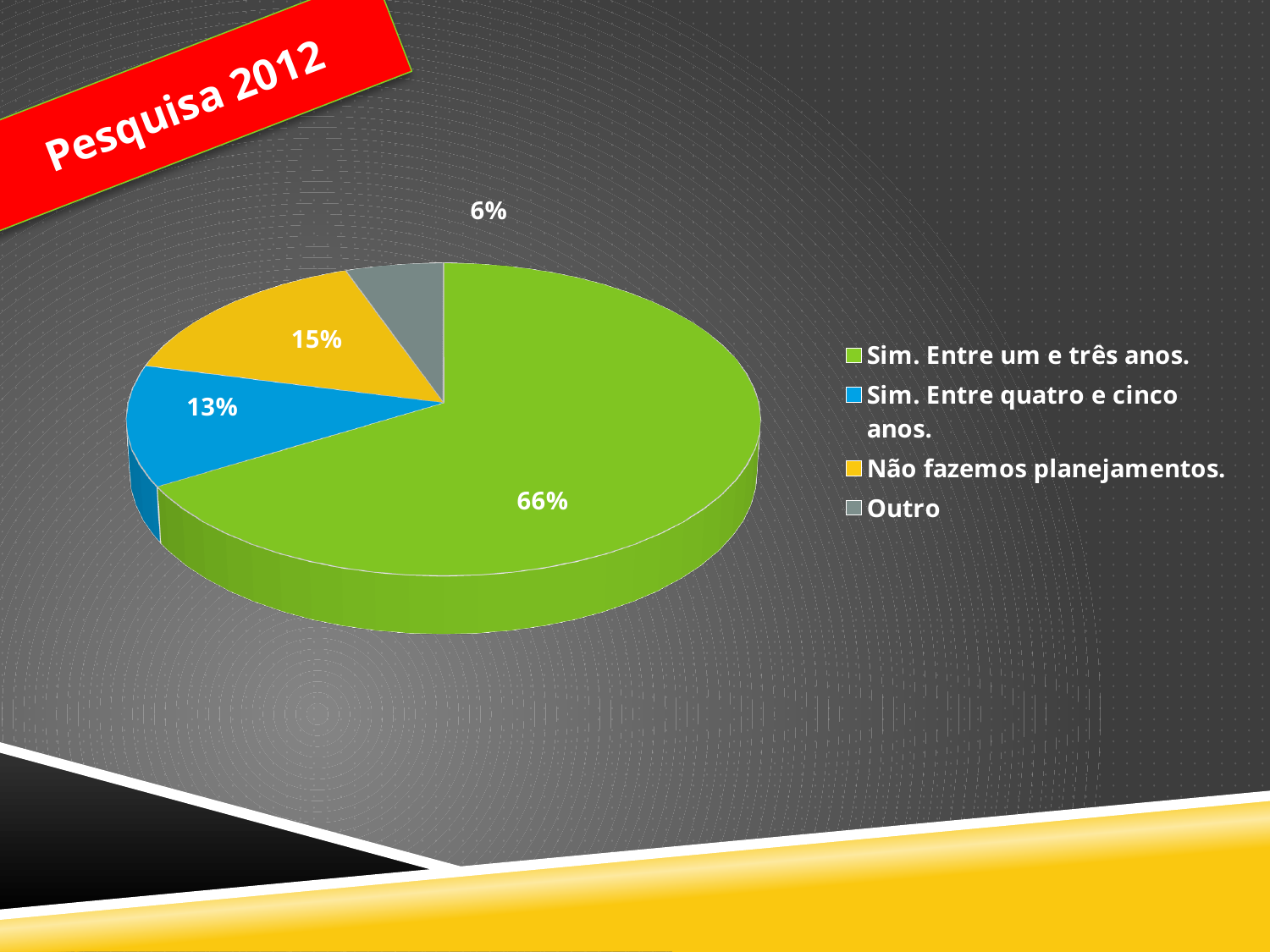
What share of the pie does 'Outro' represent? 6% Which is larger: the slice for 'Sim. Entre quatro e cinco anos.' or the slice for 'Outro'? Sim. Entre quatro e cinco anos. What share of the pie does 'Sim. Entre quatro e cinco anos.' represent? 13% Which category has the smallest slice of the pie? Outro What colour is the slice for 'Não fazemos planejamentos.'? Yellow Which category has the largest slice of the pie? Sim. Entre um e três anos. What is the difference in percentage points between 'Sim. Entre um e três anos.' and 'Não fazemos planejamentos.'? 51 What share of the pie does 'Não fazemos planejamentos.' represent? 15% How many categories does the pie chart show? 4 What is the difference in percentage points between 'Não fazemos planejamentos.' and 'Sim. Entre quatro e cinco anos.'? 2 What kind of chart is shown on the slide? Pie chart